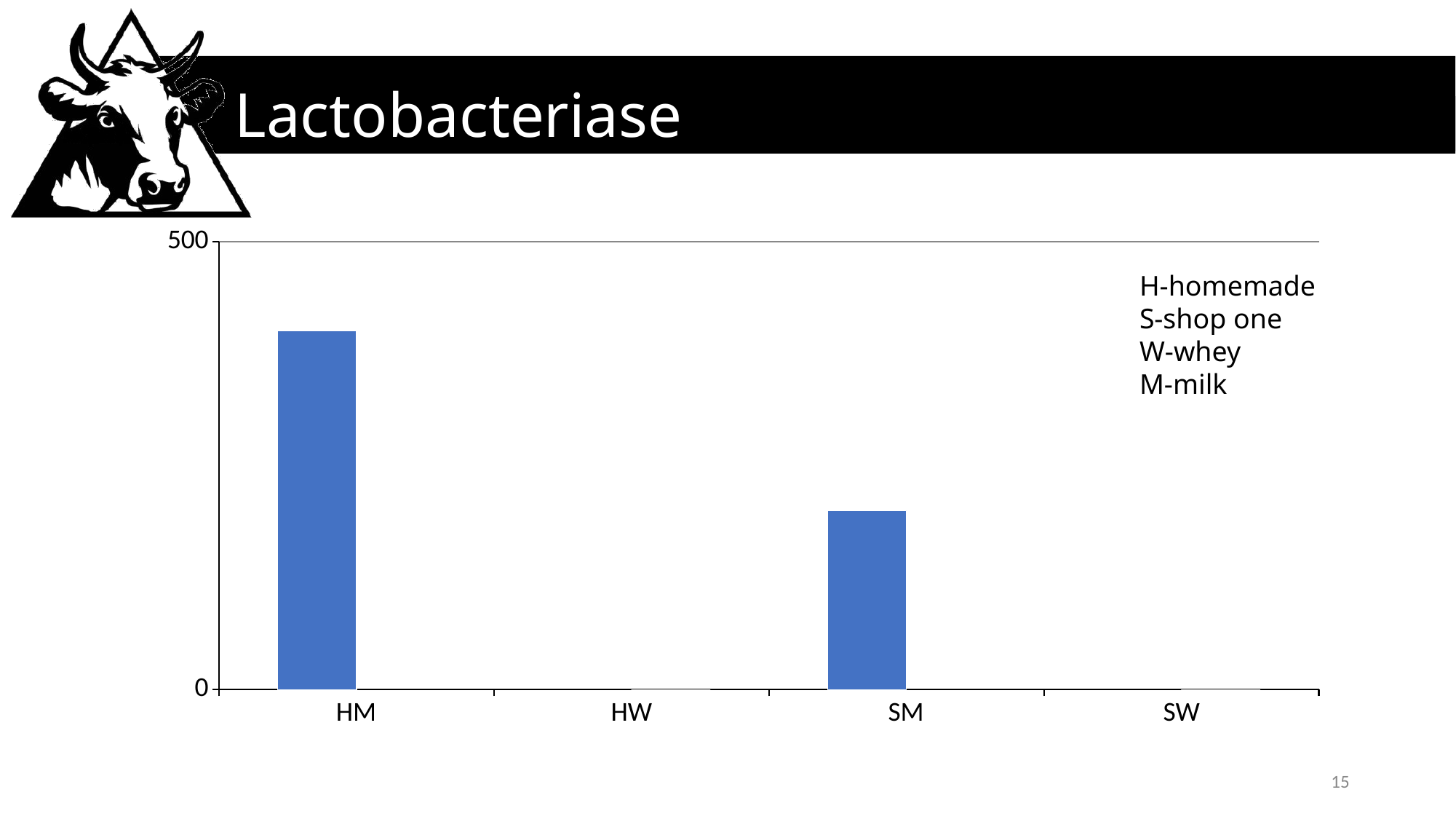
What kind of chart is shown on the slide? bar chart Which category has the highest bar in the chart? HM What is the title of the slide containing the chart? Lactobacteriase How many categories are shown on the x axis of the chart? 4 Is the value for SM greater or less than 500? less Is the value for HM greater or less than 0? greater Is the value for HM greater or less than 500? less Which is larger, the value for HM or the value for SM? HM What is the highest value shown on the y axis of the chart? 500 According to the key on the slide, what does the letter W stand for in the category labels? whey How many categories in the chart have a visible bar? 2